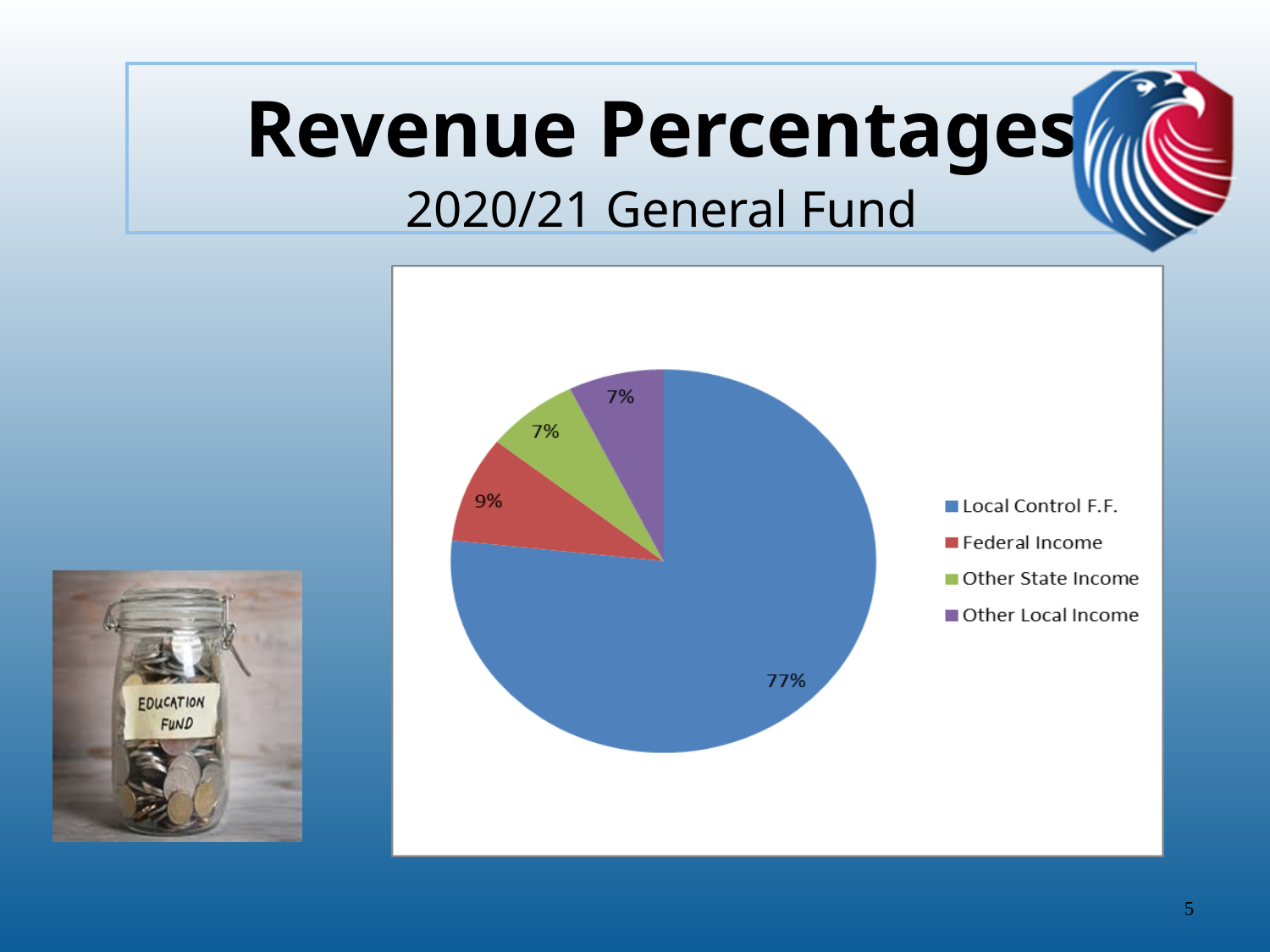
Which category has the largest share of the pie? Local Control F.F. What is the combined share of Federal Income, Other State Income and Other Local Income? 23% How many categories does the legend list? 4 What is the difference in percentage points between Local Control F.F. and Federal Income? 68 What percentage of the pie is Federal Income? 9% What percentage of the pie is Local Control F.F.? 77% What colour is the Federal Income slice? Red What percentage of the pie is Other Local Income? 7% What percentage of the pie is Other State Income? 7% Which is larger, Federal Income or Other State Income? Federal Income What fiscal year does the chart's subtitle refer to? 2020/21 What kind of chart is shown on the slide? Pie chart